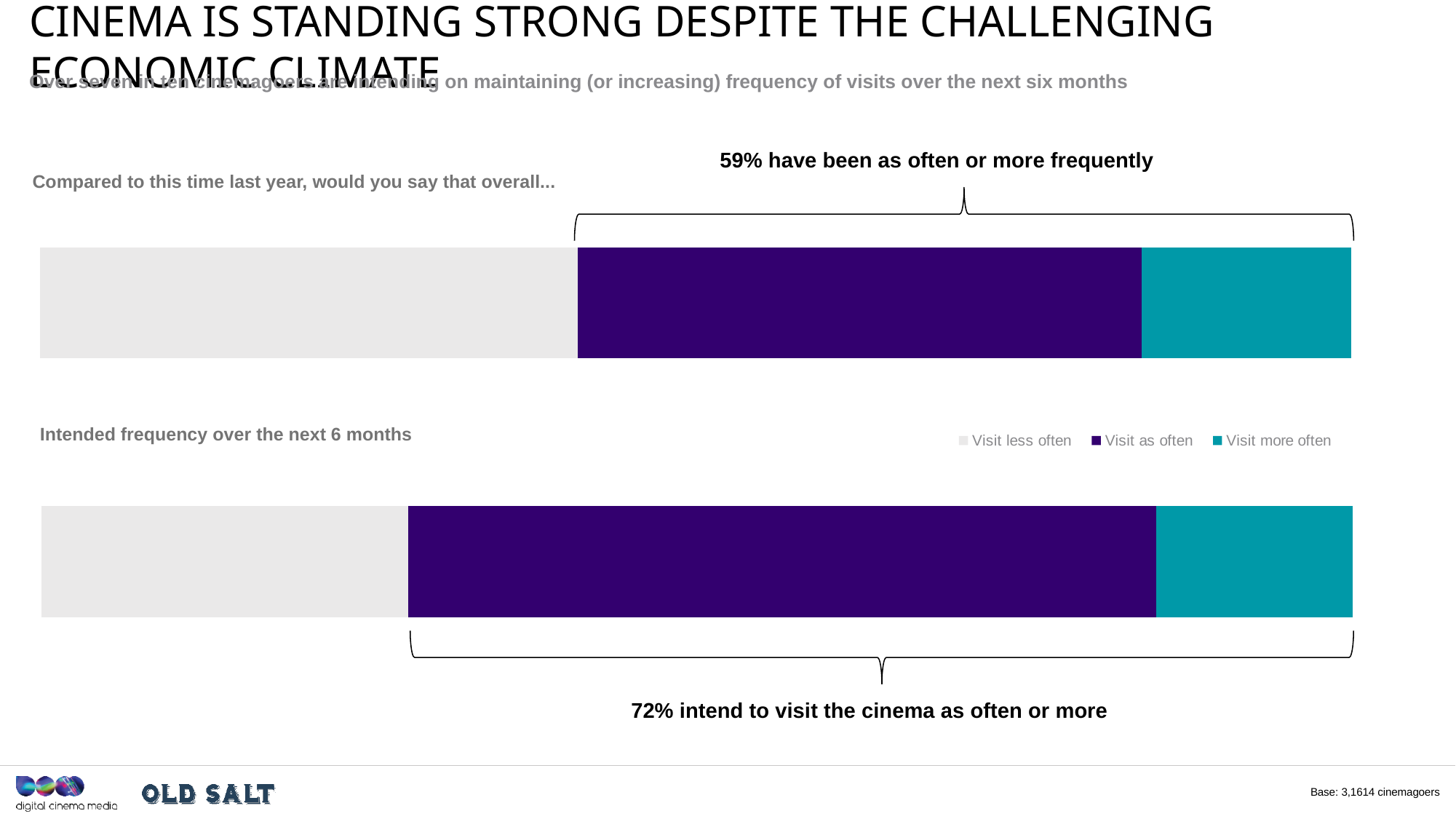
What colour represents 'Visit more often' in the chart? Teal How many series does the legend list? 3 According to the annotation on the bottom bar, what percentage intend to visit the cinema as often or more over the next 6 months? 72% What kind of chart is shown on the slide? Stacked bar chart What are the three entries in the legend? Visit less often, Visit as often, Visit more often In the 'Intended frequency over the next 6 months' bar, which segment is the largest? Visit as often According to the annotation on the top bar, what percentage have visited as often or more frequently compared to this time last year? 59% How many stacked bars are plotted on the slide? 2 Which is larger: the share who have visited as often or more compared to last year, or the share who intend to visit as often or more over the next 6 months? Intended frequency over the next 6 months (72%) In the 'Compared to this time last year' bar, which segment is larger: 'Visit as often' or 'Visit more often'? Visit as often In the 'Intended frequency over the next 6 months' bar, which segment is the smallest? Visit more often What is the difference in percentage points between the 72% who intend to visit as often or more and the 59% who have visited as often or more? 13 percentage points